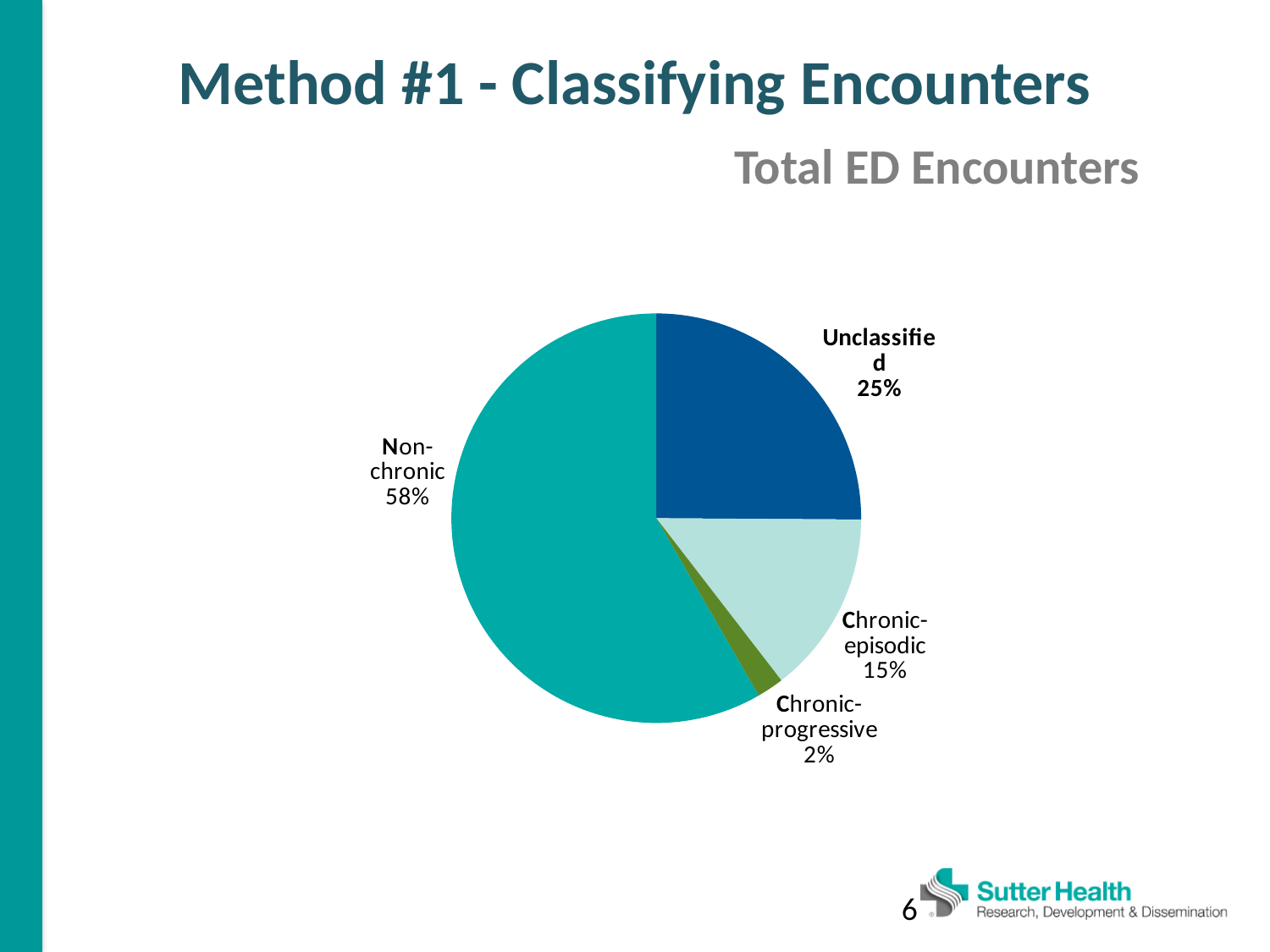
What type of chart is shown on the slide? Pie chart Which category has the smallest share of total ED encounters? Chronic-progressive How many percentage points larger is the Non-chronic share than the Unclassified share? 33 Which is larger, the Unclassified share or the Chronic-episodic share? Unclassified What share of total ED encounters is Chronic-progressive? 2% What is the difference in percentage points between the Chronic-episodic and Chronic-progressive shares? 13 What share of total ED encounters is Chronic-episodic? 15% How many categories are shown in the pie chart? 4 What is the title of the chart? Total ED Encounters What share of total ED encounters is Non-chronic? 58% Which category has the largest share of total ED encounters? Non-chronic What share of total ED encounters is Unclassified? 25%